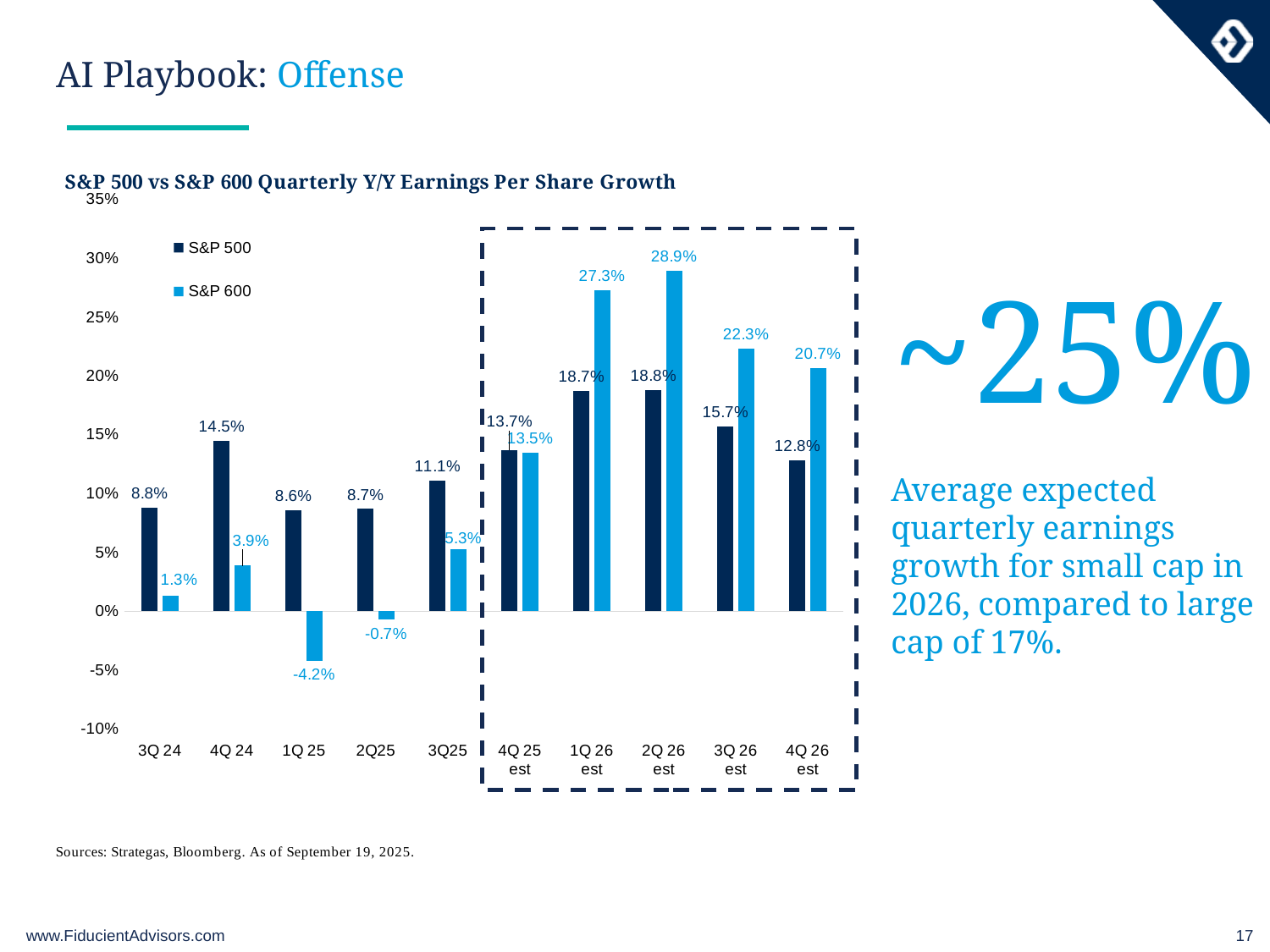
What is the S&P 600 value for 2Q 26 est? 28.9% What is the S&P 500 value for 4Q 24? 14.5% How many series does the legend list? 2 In which quarter is the S&P 600 value highest? 2Q 26 est In which quarter is the S&P 600 value lowest? 1Q 25 For 1Q 26 est, which series has the larger value, S&P 500 or S&P 600? S&P 600 What is the S&P 600 value for 1Q 25? -4.2% What kind of chart is shown on the slide? Bar chart What is the difference between the S&P 500 and S&P 600 values for 3Q 24? 7.5 percentage points What is the S&P 500 value for 4Q 26 est? 12.8% What is the difference between the S&P 600 and S&P 500 values for 2Q 26 est? 10.1 percentage points How many quarters are shown on the x axis? 10